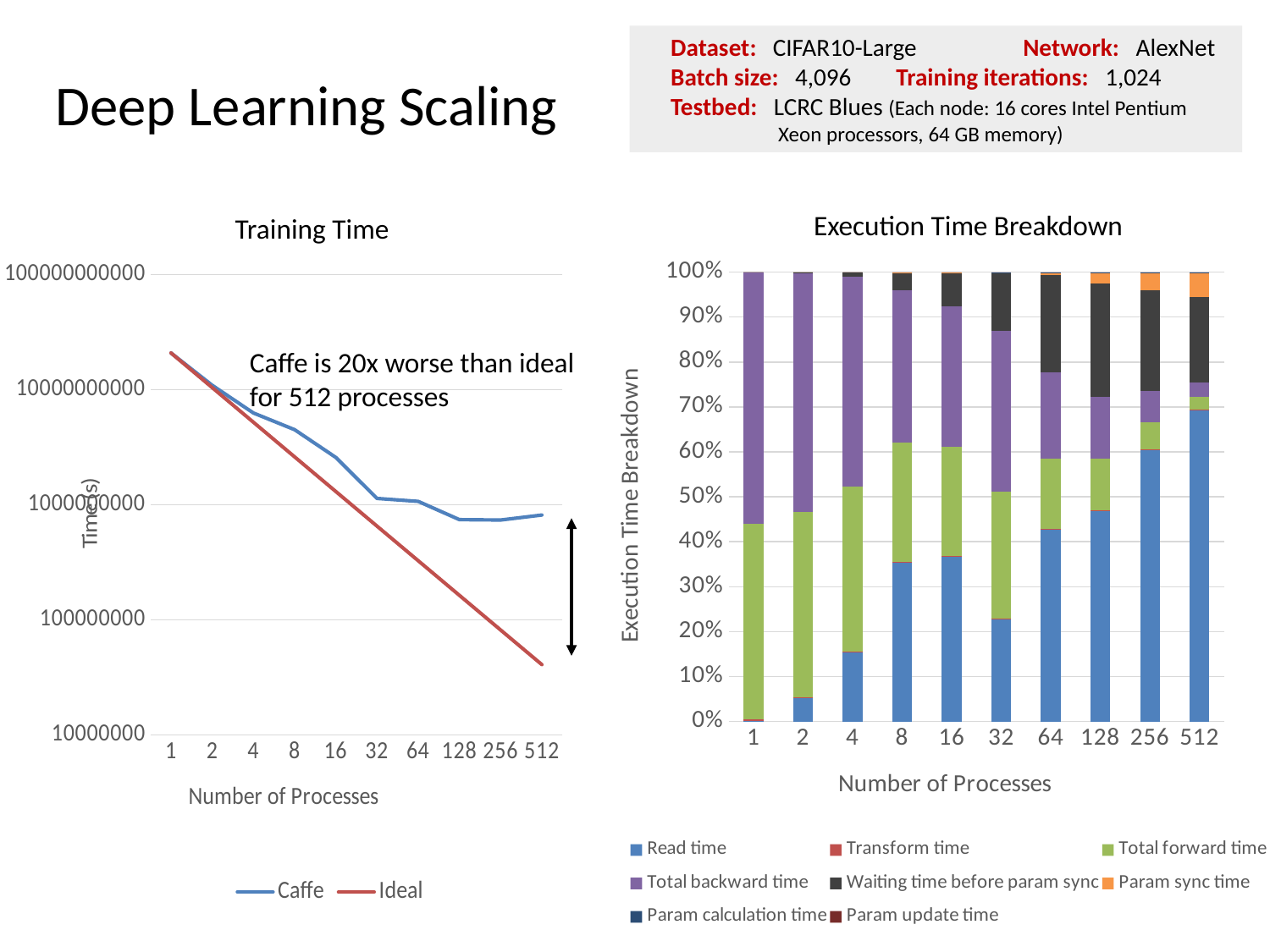
In the "Training Time" chart, which series has the higher value at 512 processes, Caffe or Ideal? Caffe In the "Execution Time Breakdown" chart, does the Read time share rise or fall as the number of processes increases? rise How many series does the legend of the "Training Time" chart list? 2 In the "Execution Time Breakdown" chart, what is the total height of each stacked bar? 100% How many process counts are shown on the x axis of the "Execution Time Breakdown" chart? 10 What kind of chart is the "Execution Time Breakdown" chart? stacked bar chart In the "Training Time" chart, does the Caffe line rise or fall as the number of processes increases? fall What kind of chart is the "Training Time" chart? line chart In the "Execution Time Breakdown" chart, is the Read time share for 1 process greater or less than 10%? less In the "Execution Time Breakdown" chart, is the Read time share for 512 processes greater or less than 60%? greater How many series does the legend of the "Execution Time Breakdown" chart list? 8 In the "Execution Time Breakdown" chart, which colour represents Read time? blue